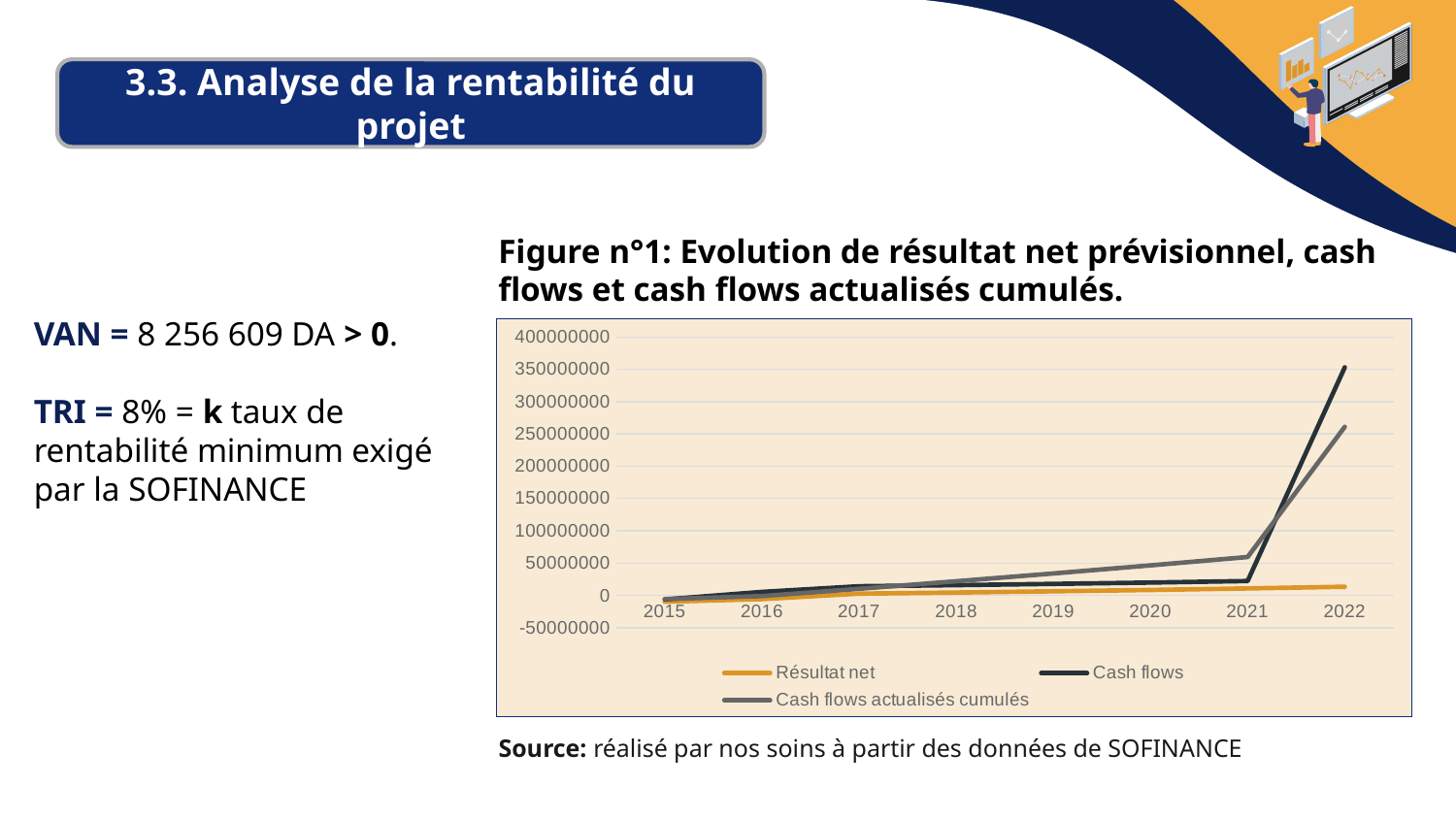
Is the value of Cash flows actualisés cumulés in 2022 greater or less than 200000000? greater Is the value of Cash flows actualisés cumulés in 2022 greater or less than 300000000? less In 2022, which is larger: Cash flows or Cash flows actualisés cumulés? Cash flows Is the value of Résultat net in 2022 greater or less than 50000000? less In which year does the Cash flows series reach its highest value? 2022 How many years are shown on the x axis of the chart? 8 What is the title of the figure on the slide? Figure n°1: Evolution de résultat net prévisionnel, cash flows et cash flows actualisés cumulés. Which series are listed in the chart legend? Résultat net, Cash flows, Cash flows actualisés cumulés Does the Cash flows series generally rise or fall from 2015 to 2022? rise What kind of chart is shown on the slide? line chart How many series does the chart legend list? 3